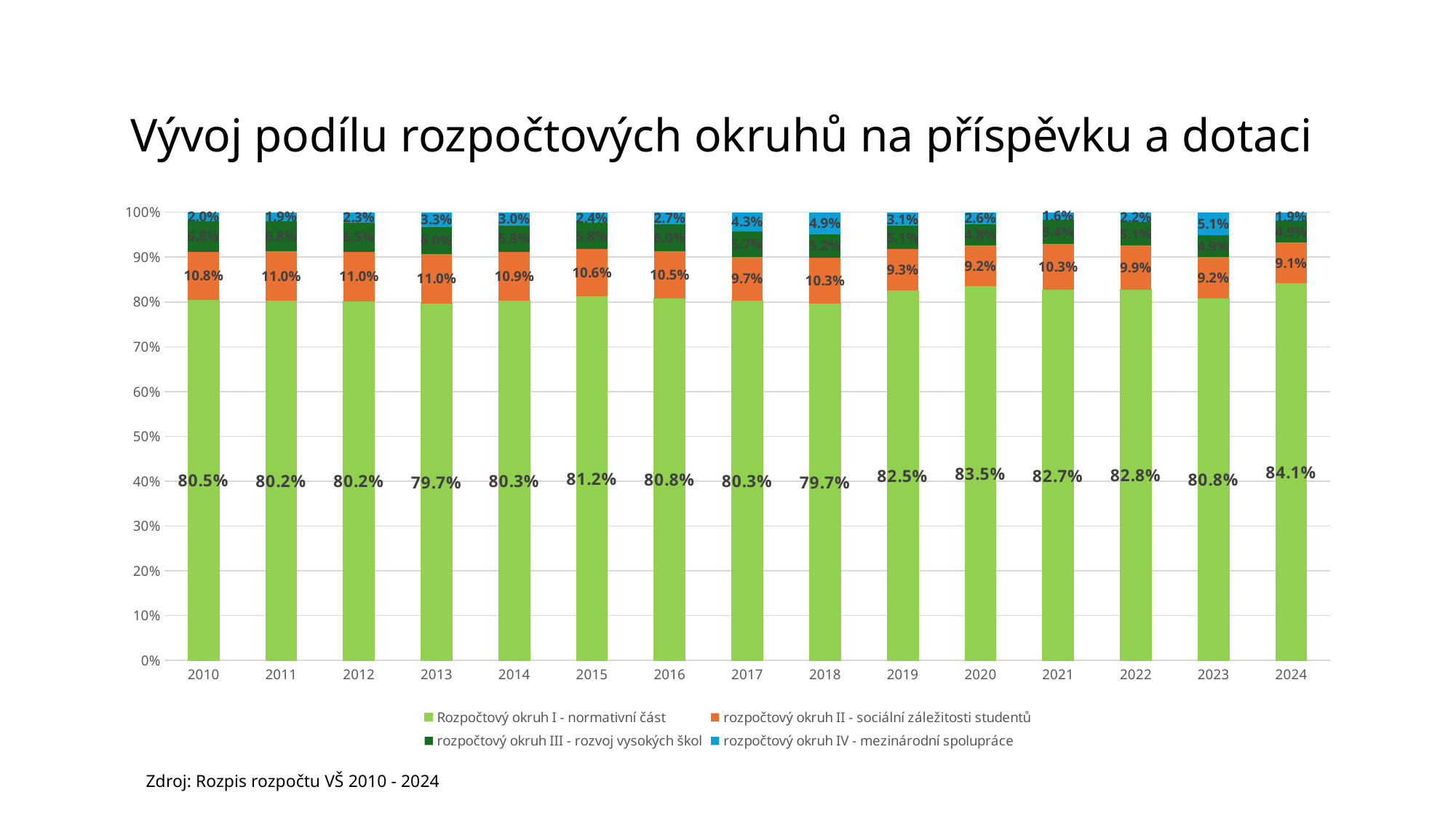
What is the value for rozpočtový okruh II - sociální záležitosti studentů in 2010? 10.8% How many series does the legend list? 4 What is the difference between the Rozpočtový okruh I - normativní část values for 2024 and 2010? 3.6% What is the value for Rozpočtový okruh I - normativní část in 2024? 84.1% What is the value for rozpočtový okruh IV - mezinárodní spolupráce in 2023? 5.1% In which year is the share of Rozpočtový okruh I - normativní část the highest? 2024 Which year has a larger share of Rozpočtový okruh I - normativní část, 2020 or 2021? 2020 What kind of chart is shown on the slide? Stacked bar chart What is the value for Rozpočtový okruh I - normativní část in 2013? 79.7% What is the title of the chart? Vývoj podílu rozpočtových okruhů na příspěvku a dotaci In which year is the share of rozpočtový okruh II - sociální záležitosti studentů the lowest? 2024 How many years are shown on the x axis? 15